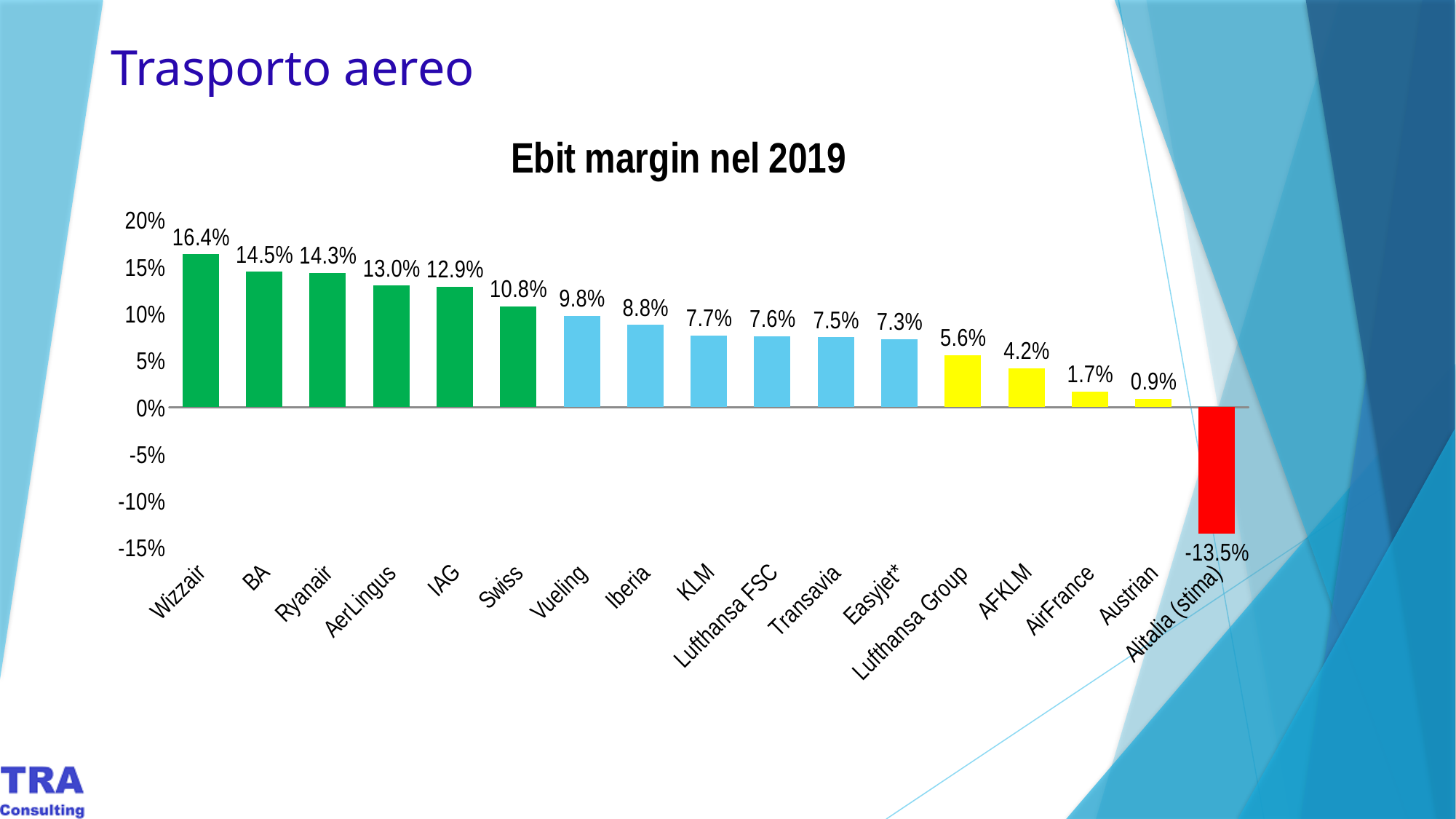
What is the Ebit margin for Alitalia (stima)? -13.5% What is the Ebit margin for Lufthansa Group? 5.6% Which airline has the highest Ebit margin? Wizzair What is the title of the chart? Ebit margin nel 2019 What is the Ebit margin for Ryanair? 14.3% Which airline has the lowest Ebit margin? Alitalia (stima) How many airlines are shown in the chart? 17 What is the difference between the Ebit margins of Vueling and AirFrance? 8.1% Is the Ebit margin for AerLingus greater or less than 10%? greater What kind of chart is shown on the slide? bar chart What is the difference between the Ebit margins of Wizzair and BA? 1.9% Which has a higher Ebit margin, Swiss or Iberia? Swiss